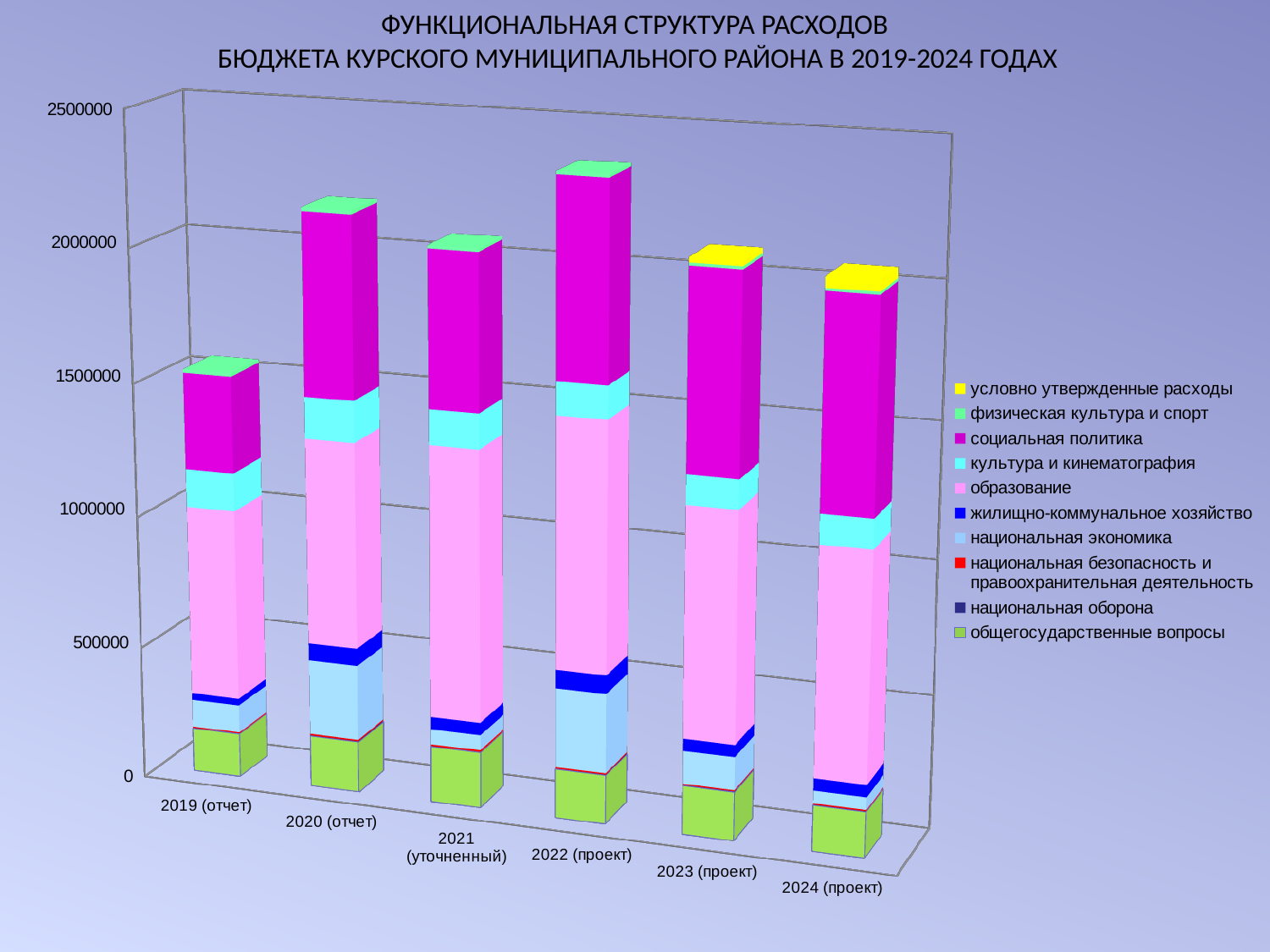
How many years (categories) are shown along the x axis? 6 What kind of chart is shown on the slide? stacked bar chart Which stacked bar is taller, 2019 (отчет) or 2022 (проект)? 2022 (проект) How many series does the legend list? 10 Is the total of the stacked bar for 2019 (отчет) greater or less than 2000000? less Which stacked bar is taller, 2020 (отчет) or 2021 (уточненный)? 2020 (отчет) Which year has the tallest stacked bar (highest total expenditure)? 2022 (проект) Which series is listed first (at the top) in the legend? условно утвержденные расходы Which series occupies the largest portion of each stacked bar? образование Which year has the shortest stacked bar (lowest total expenditure)? 2019 (отчет) Is the total of the stacked bar for 2022 (проект) greater or less than 2000000? greater